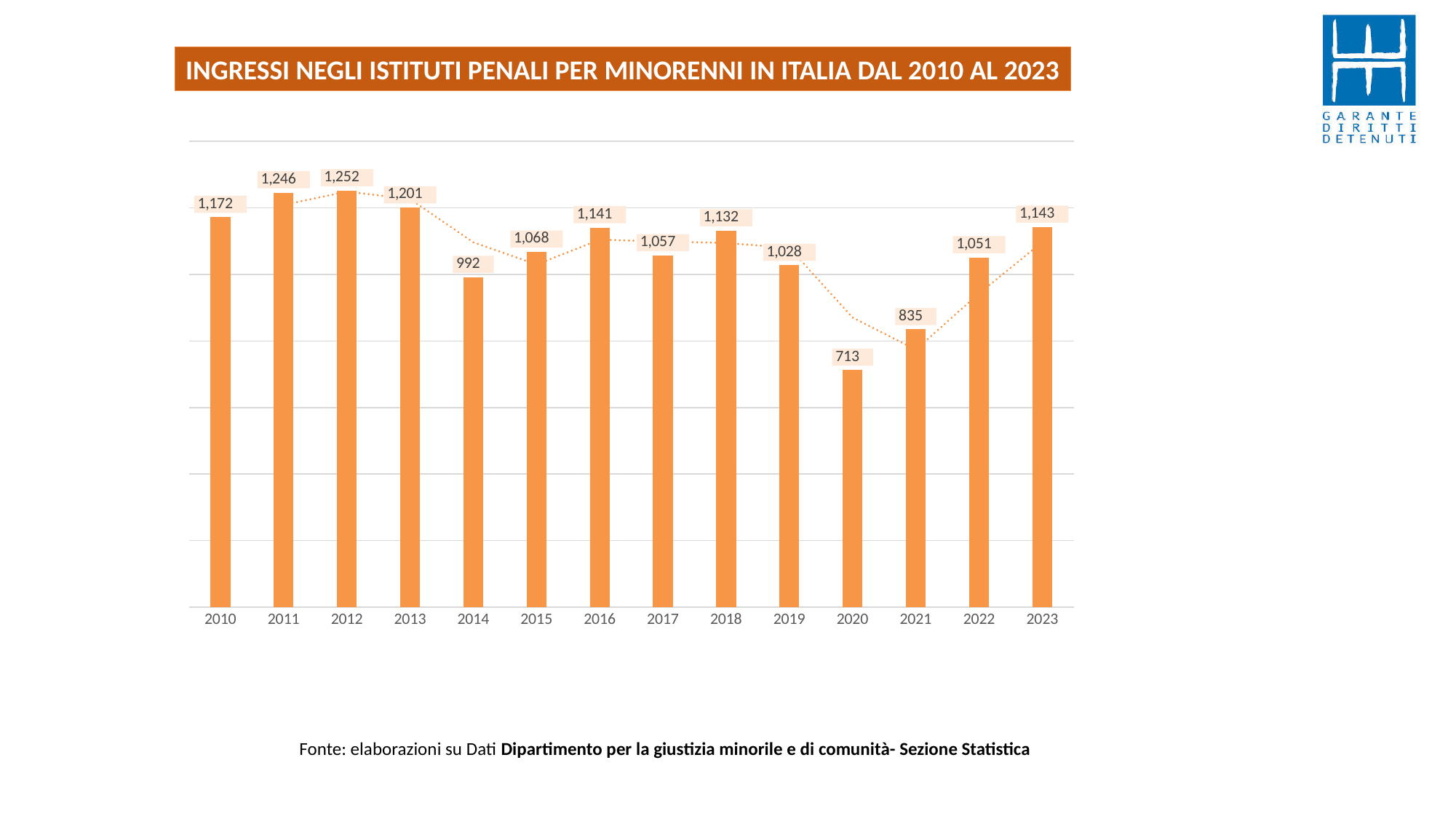
What is the title of the chart? INGRESSI NEGLI ISTITUTI PENALI PER MINORENNI IN ITALIA DAL 2010 AL 2023 What kind of chart is shown on the slide? Bar chart What is the difference between the values for 2012 and 2020? 539 What is the difference between the values for 2021 and 2022? 216 Which year has the lowest value? 2020 What is the value for 2020? 713 Which is larger, the value for 2016 or the value for 2018? 2016 What is the value for 2023? 1,143 What is the value for 2010? 1,172 Which year has the highest value? 2012 How many years are shown on the x axis? 14 What is the value for 2014? 992